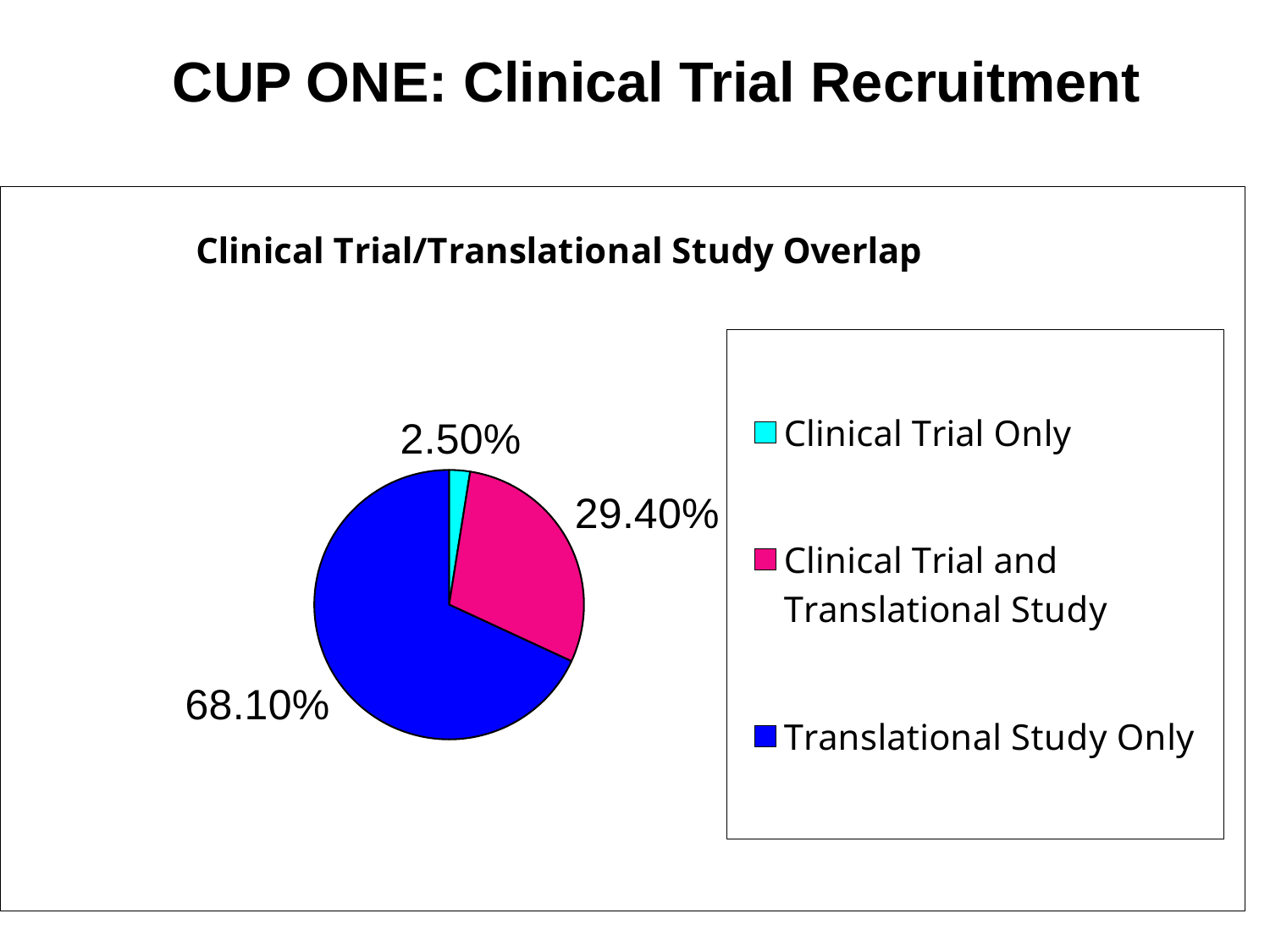
Which category has the largest share of the pie? Translational Study Only What is the title of the chart? Clinical Trial/Translational Study Overlap What percentage is shown for Clinical Trial and Translational Study? 29.40% What percentage is shown for Translational Study Only? 68.10% Which is larger, the share for Clinical Trial and Translational Study or the share for Clinical Trial Only? Clinical Trial and Translational Study Which category has the smallest share of the pie? Clinical Trial Only How many slices does the pie chart have? 3 What percentage is shown for Clinical Trial Only? 2.50% How many entries does the legend list? 3 What kind of chart is shown on the slide? pie chart What is the difference in percentage points between Translational Study Only and Clinical Trial and Translational Study? 38.70% What colour is the slice for Clinical Trial Only? cyan